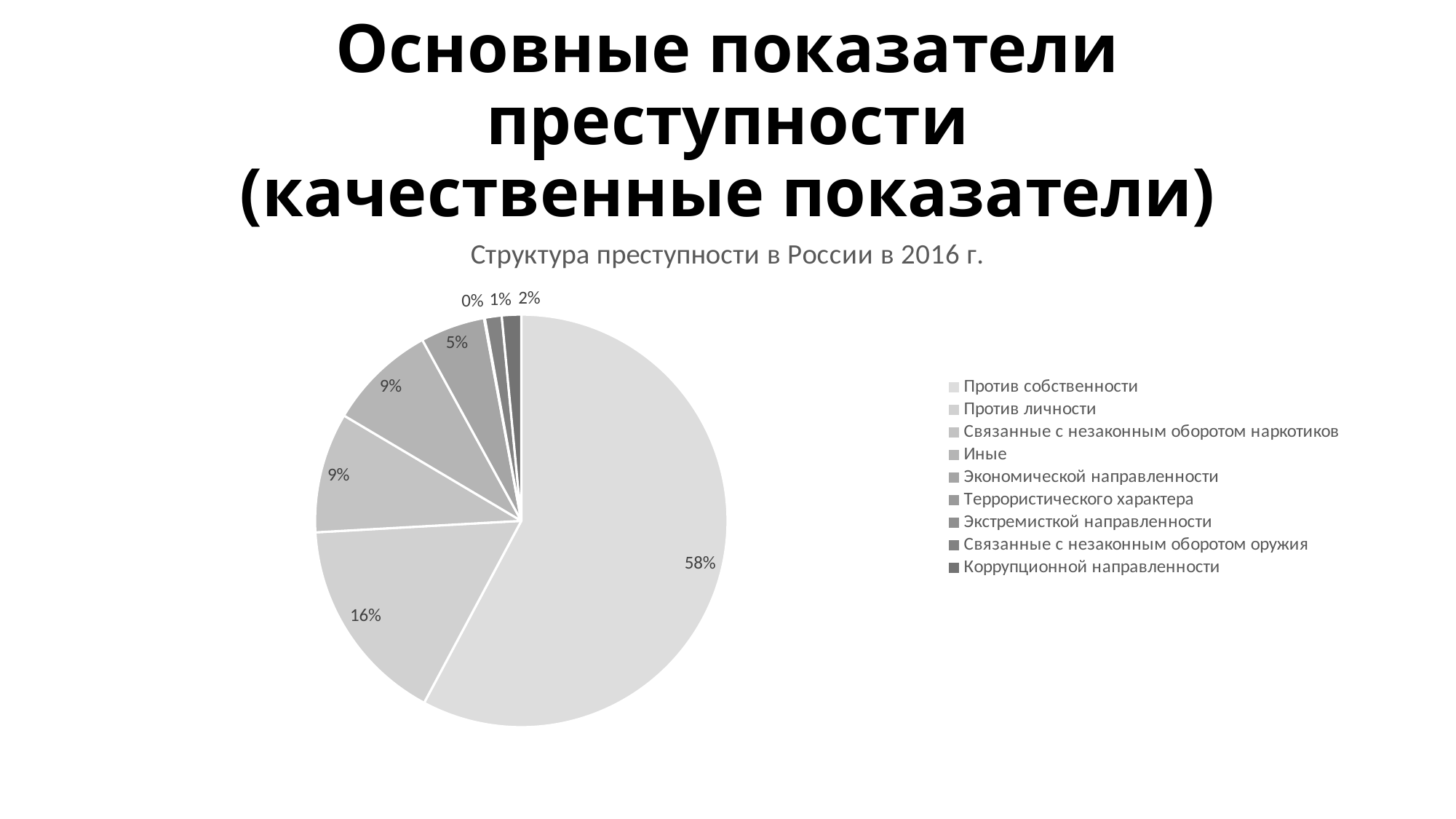
Which is larger, the share for Против личности or the share for Экономической направленности? Против личности What is the value shown for Экономической направленности? 5% What is the difference in percentage points between Против личности and Иные? 7 Which category has the largest share of the pie? Против собственности What kind of chart is shown on the slide? pie chart What share of the pie does Против собственности have? 58% What is the value shown for Связанные с незаконным оборотом наркотиков? 9% How many categories does the legend list? 9 What is the title of the chart? Структура преступности в России в 2016 г. What is the difference in percentage points between Против собственности and Против личности? 42 What is the value shown for Против личности? 16% Is the share for Против собственности greater or less than 50%? greater